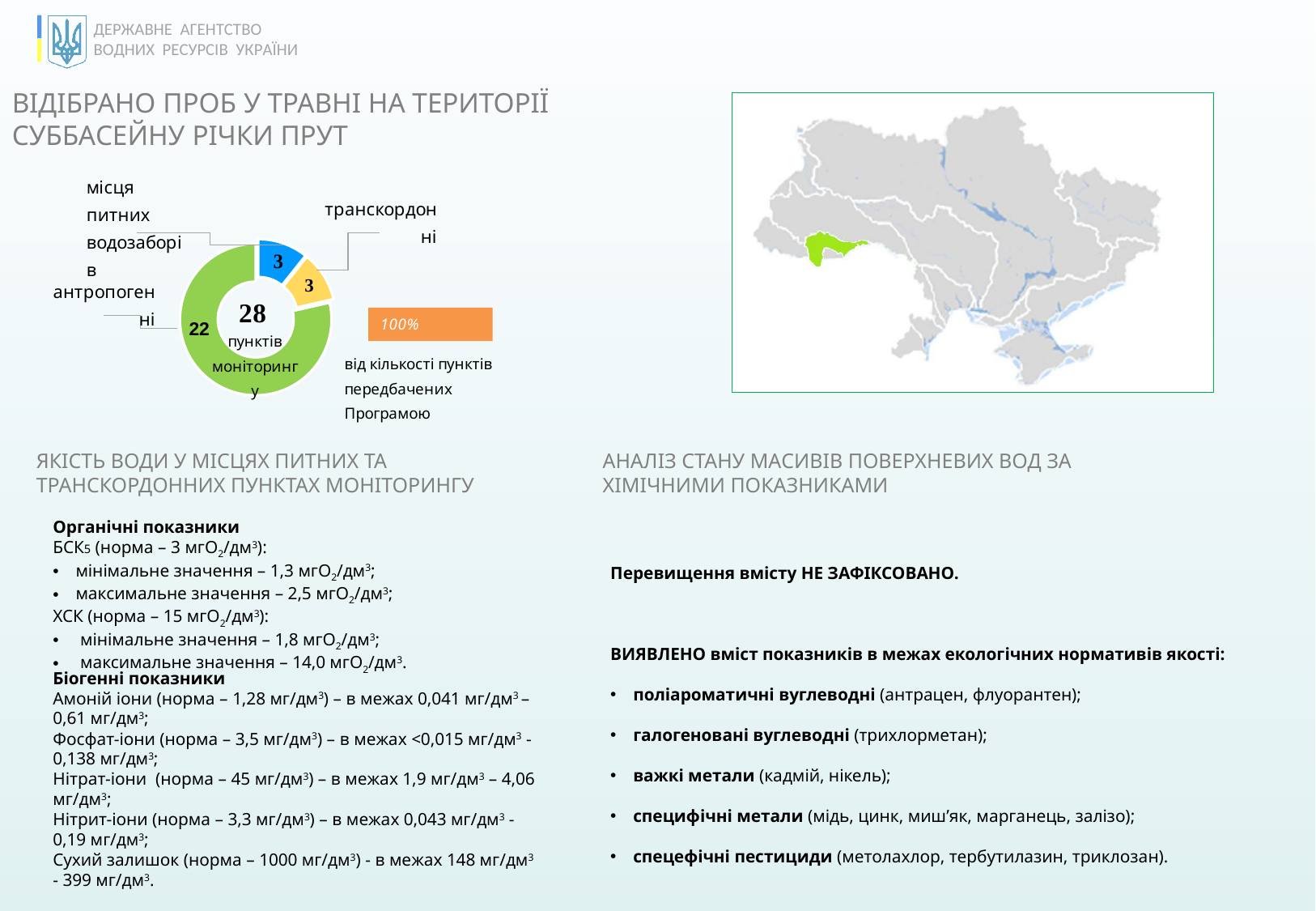
How many categories does the doughnut chart show? 3 Which category has the highest value in the doughnut chart? антропогенні Which is larger in the doughnut chart: антропогенні or місця питних водозаборів? антропогенні What number is shown in the centre of the doughnut chart? 28 What is the difference between the антропогенні value and the транскордонні value in the doughnut chart? 19 What is the total of all segments in the doughnut chart? 28 What type of chart is shown on the slide? Doughnut (pie) chart What is the value for the антропогенні category in the doughnut chart? 22 What is the value for the транскордонні category in the doughnut chart? 3 Is the value for антропогенні in the doughnut chart greater or less than 20? greater What colour is the антропогенні segment of the doughnut chart? Green What is the value for the місця питних водозаборів category in the doughnut chart? 3